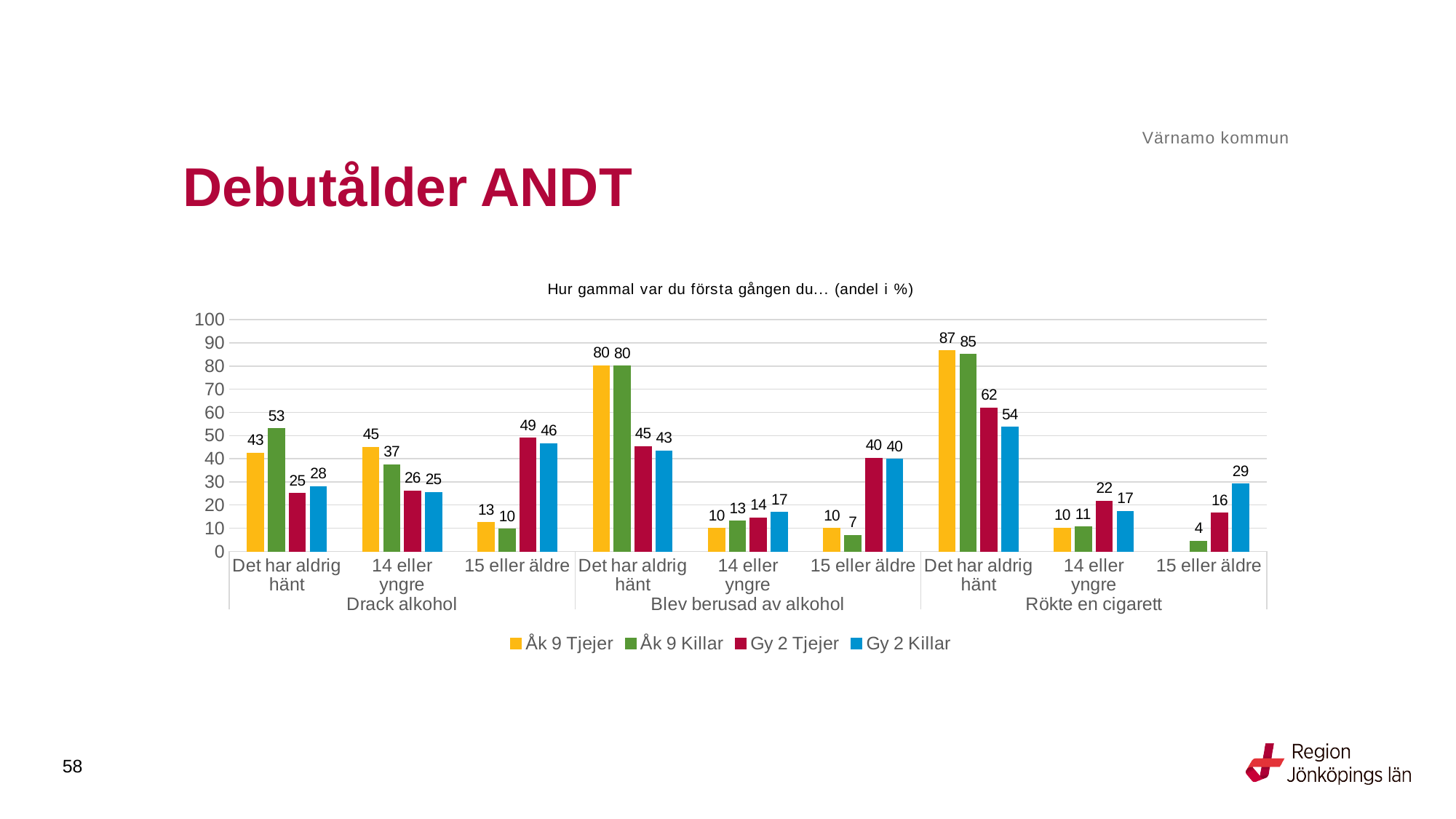
What kind of chart is shown on the slide? Bar chart Which series has the highest value under "Det har aldrig hänt" in the "Rökte en cigarett" group? Åk 9 Tjejer Under "15 eller äldre" in the "Rökte en cigarett" group, which is larger: Gy 2 Tjejer or Gy 2 Killar? Gy 2 Killar How many category groups (questions) are shown along the x axis? 3 What is the value for Åk 9 Killar under "Det har aldrig hänt" in the "Drack alkohol" group? 53 What is the value for Gy 2 Tjejer under "15 eller äldre" in the "Drack alkohol" group? 49 Which series has the lowest value under "15 eller äldre" in the "Blev berusad av alkohol" group? Åk 9 Killar How many series does the legend list? 4 What is the difference between Åk 9 Tjejer and Åk 9 Killar under "14 eller yngre" in the "Drack alkohol" group? 8 What is the value for Gy 2 Killar under "Det har aldrig hänt" in the "Rökte en cigarett" group? 54 What is the title of the chart? Hur gammal var du första gången du… (andel i %) What is the difference between Gy 2 Tjejer and Gy 2 Killar under "Det har aldrig hänt" in the "Rökte en cigarett" group? 8